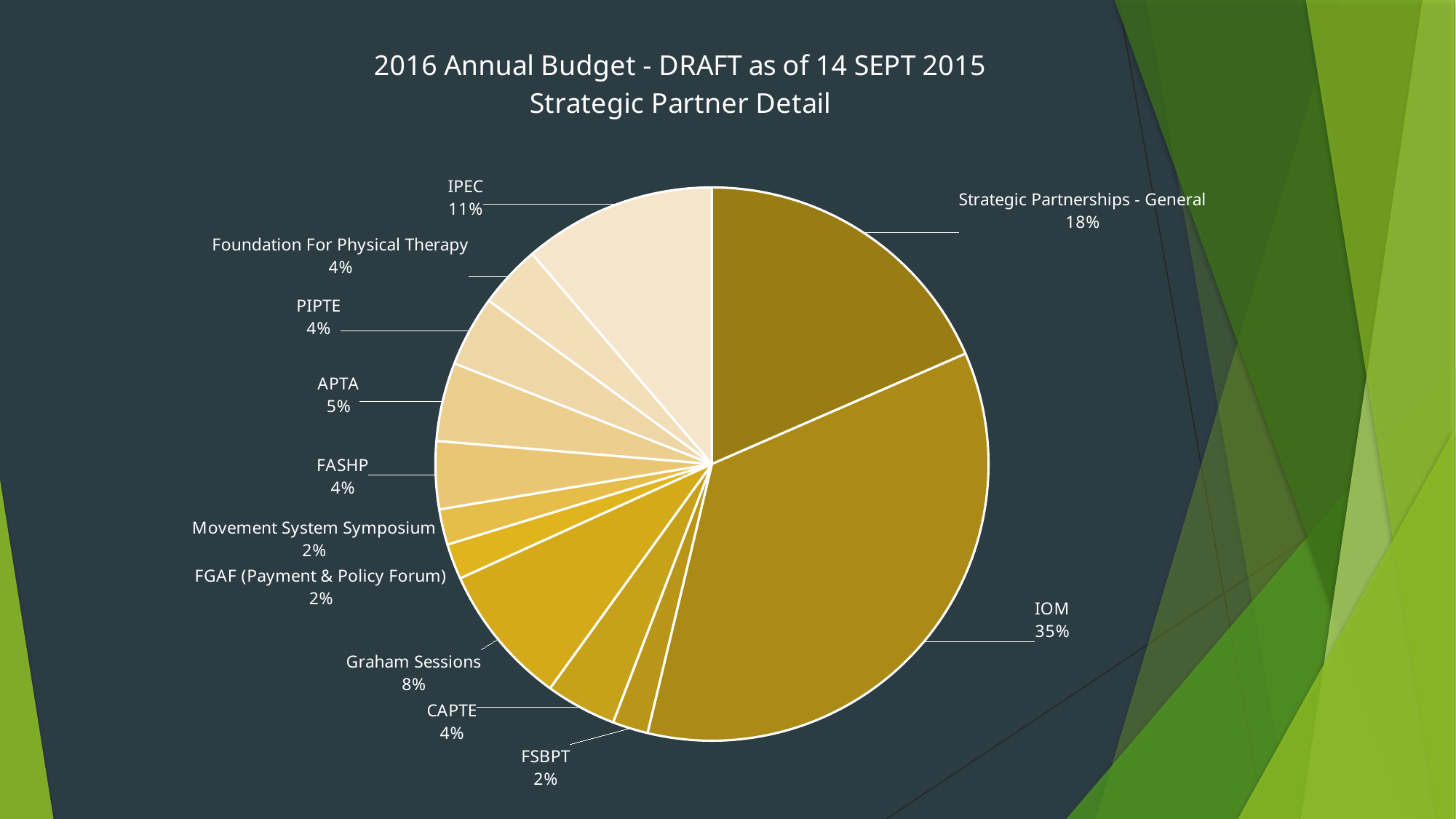
How many categories are shown in the pie chart? 12 What percentage is shown for Strategic Partnerships - General? 18% What is the difference in percentage points between APTA and CAPTE? 1 What is the title of the chart? 2016 Annual Budget - DRAFT as of 14 SEPT 2015 Strategic Partner Detail What kind of chart is shown on the slide? pie chart What is the difference in percentage points between IOM and Strategic Partnerships - General? 17 What percentage is shown for IPEC? 11% What share of the pie does IOM represent? 35% Which category has the largest slice of the pie? IOM What percentage is shown for APTA? 5% Which is larger, the share for IPEC or the share for Graham Sessions? IPEC What percentage is shown for Graham Sessions? 8%